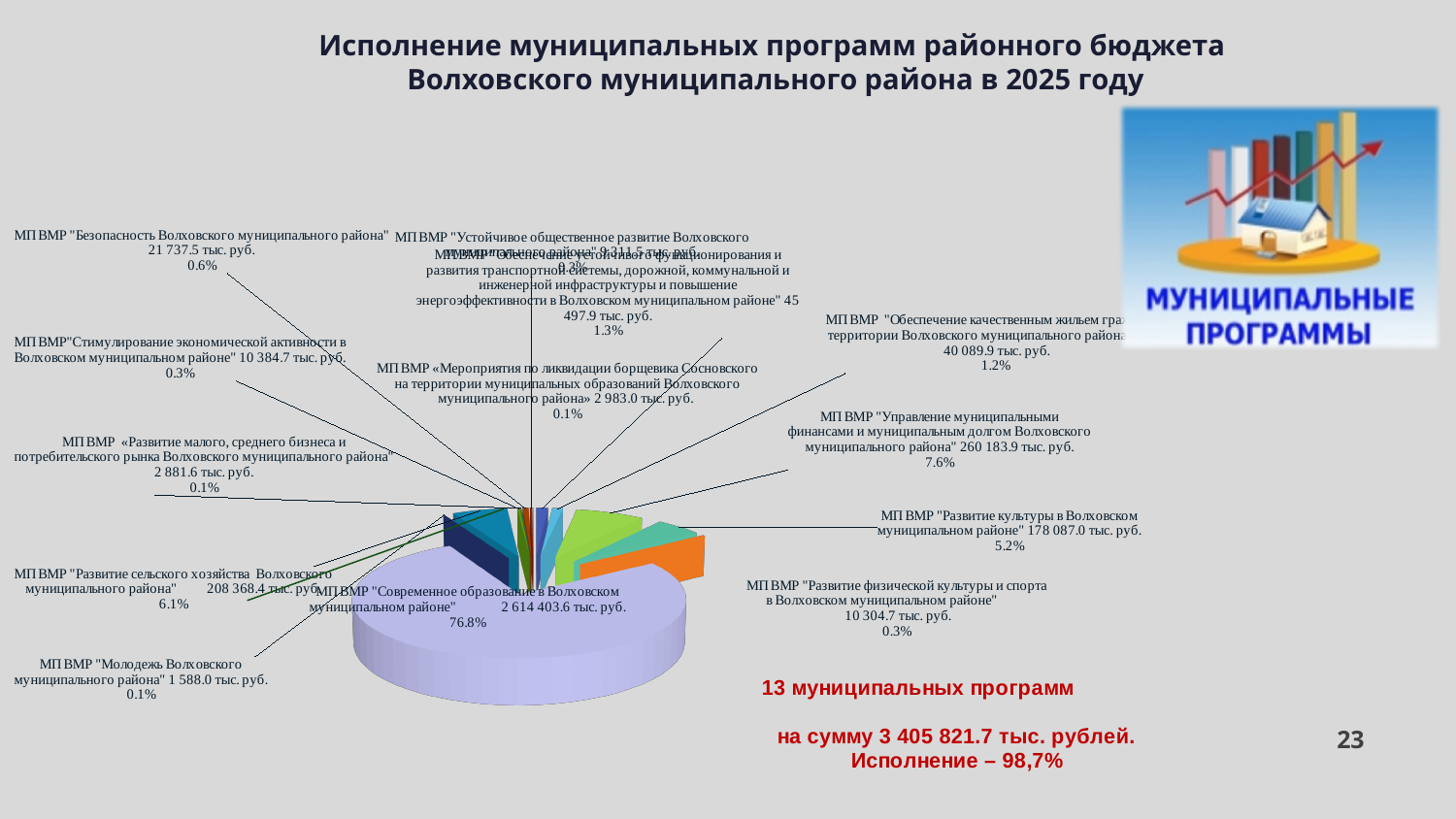
What is the value for МП ВМР "Управление муниципальными финансами и муниципальным долгом Волховского муниципального района"? 260 183.9 тыс. руб. What execution percentage (Исполнение) is stated on the slide? 98,7% What share of the pie does МП ВМР "Современное образование в Волховском муниципальном районе" have? 76.8% Which program has the largest slice of the pie? МП ВМР "Современное образование в Волховском муниципальном районе" What share of the pie does МП ВМР "Развитие сельского хозяйства Волховского муниципального района" have? 6.1% How many municipal programs does the slide say are shown in the chart? 13 Which is larger: the value for МП ВМР "Безопасность Волховского муниципального района" or for МП ВМР "Обеспечение качественным жильем граждан на территории Волховского муниципального района"? МП ВМР "Обеспечение качественным жильем граждан на территории Волховского муниципального района" What is the difference in percentage share between МП ВМР "Управление муниципальными финансами и муниципальным долгом Волховского муниципального района" and МП ВМР "Развитие культуры в Волховском муниципальном районе"? 2.4% What is the total sum of the municipal programs stated on the slide? 3 405 821.7 тыс. рублей What kind of chart is shown on the slide? pie chart Which program has the smallest value in the chart? МП ВМР "Молодежь Волховского муниципального района" What is the value for МП ВМР "Развитие культуры в Волховском муниципальном районе"? 178 087.0 тыс. руб.